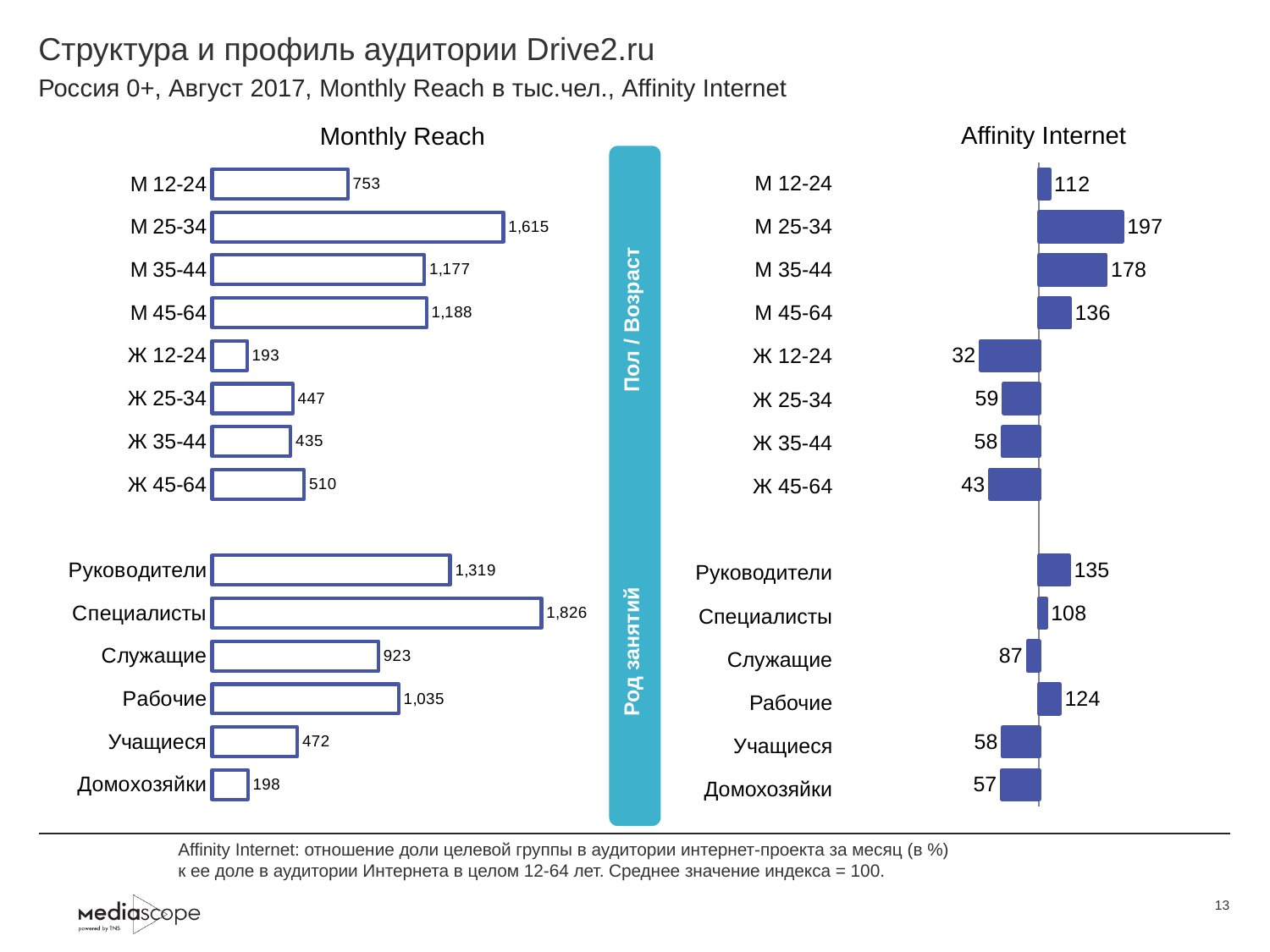
In the Monthly Reach chart, what is the difference between Специалисты and Руководители? 507 In the Monthly Reach chart, which category has the highest value? Специалисты How many categories are plotted in the Monthly Reach chart? 14 In the Affinity Internet chart, what is the value for Ж 12-24? 32 In the Monthly Reach chart, what is the value for Домохозяйки? 198 What type of chart is the Affinity Internet chart? Bar chart In the Affinity Internet chart, which is larger: Руководители or Рабочие? Руководители In the Affinity Internet chart, what is the difference between М 25-34 and М 35-44? 19 In the Monthly Reach chart, what is the value for М 25-34? 1,615 In the Affinity Internet chart, which category has the lowest value? Ж 12-24 In the Monthly Reach chart, which is larger: Рабочие or Служащие? Рабочие In the Affinity Internet chart, which category has the highest value? М 25-34